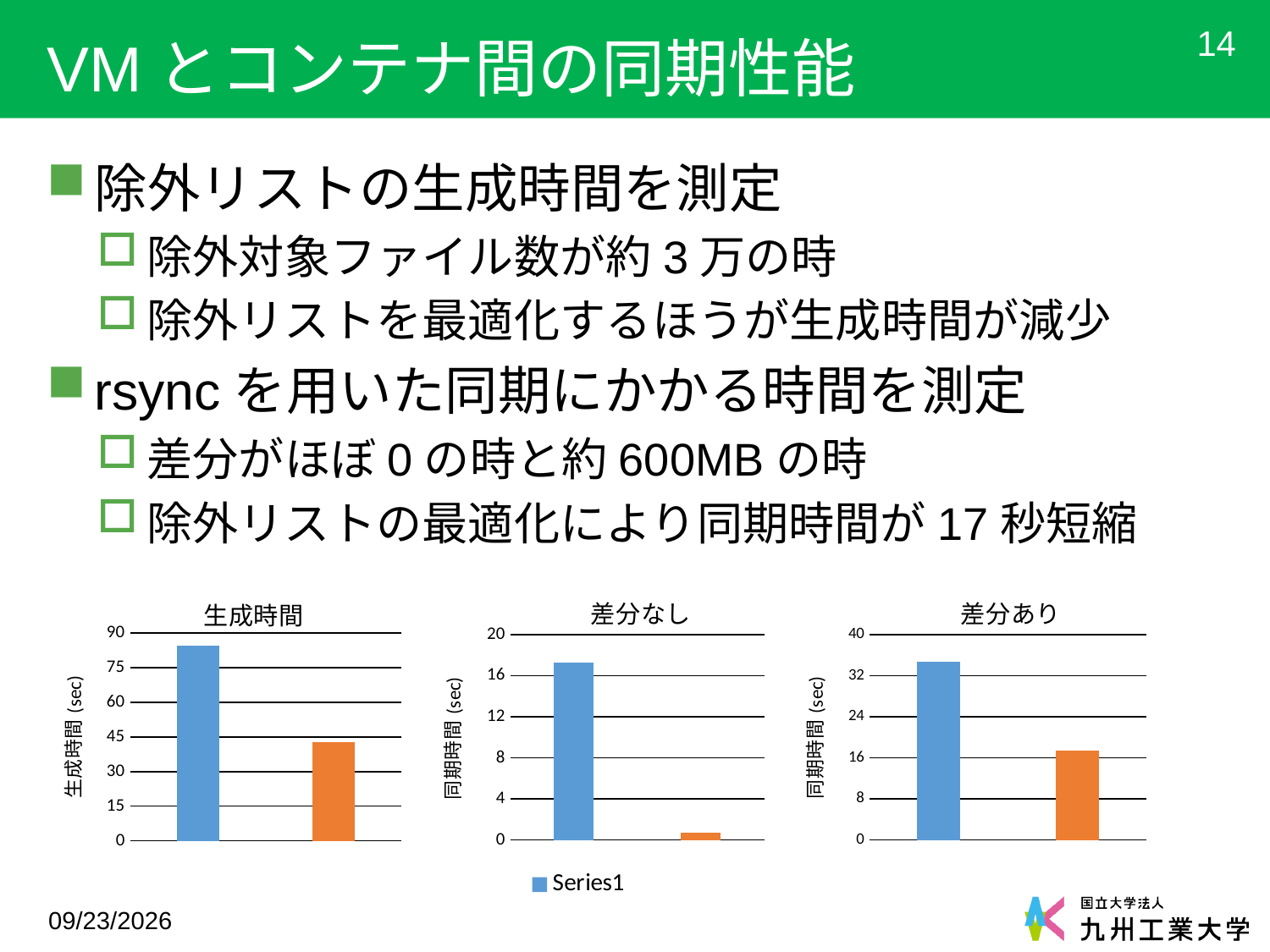
What is the title of the leftmost chart on the slide? 生成時間 In the chart titled 差分なし, is the value of the right (orange) bar greater or less than 4? less In the chart titled 生成時間, is the value of the left (blue) bar greater or less than 75? greater In the chart titled 生成時間, is the value of the right (orange) bar greater or less than 60? less What is the y-axis title of the chart titled 差分なし? 同期時間 (sec) How many series does the legend below the charts list? 1 What kind of chart is the chart titled 生成時間? bar chart In the chart titled 差分あり, which bar is taller, the blue bar or the orange bar? the blue bar How many bars are plotted in the chart titled 差分なし? 2